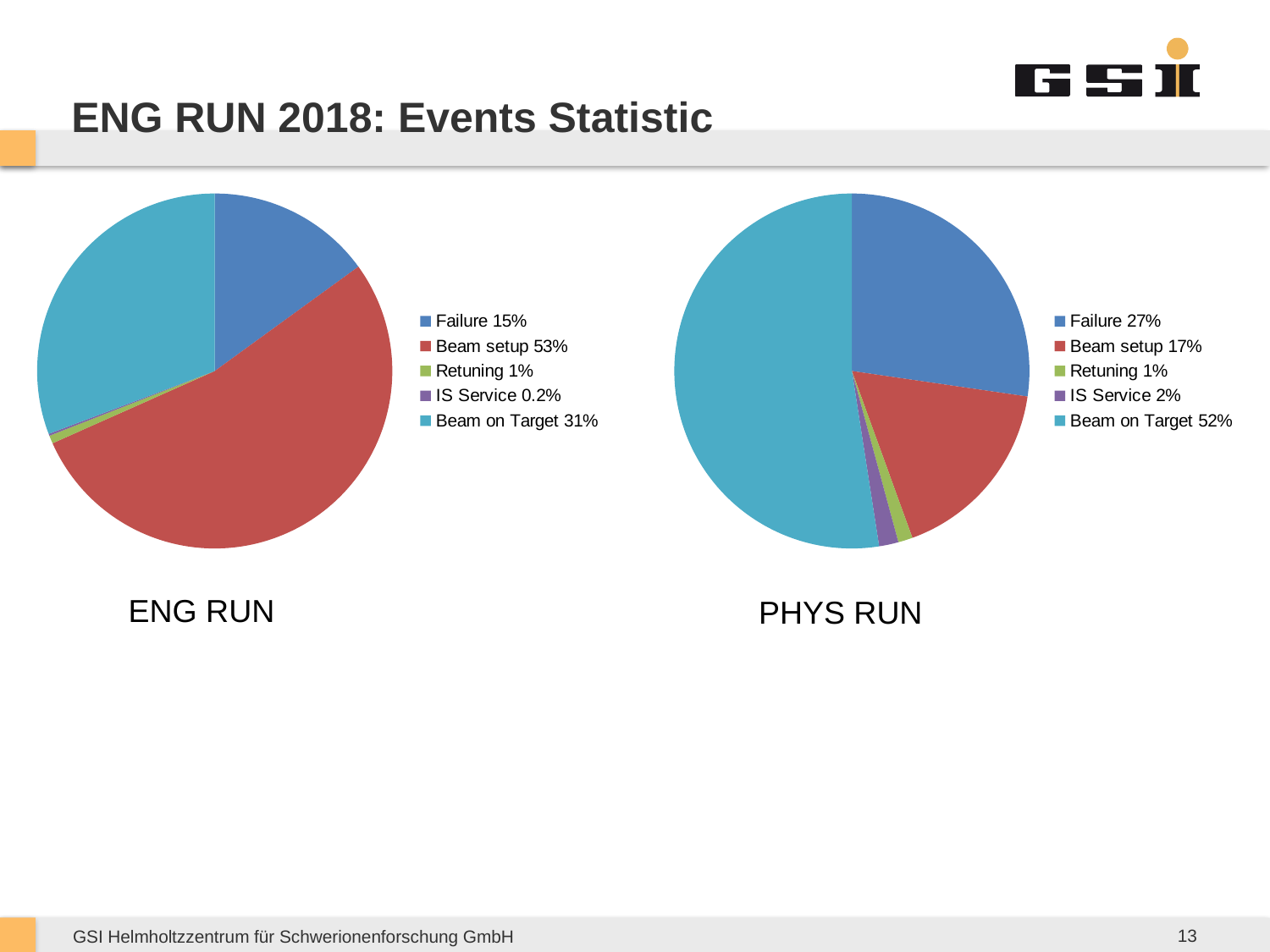
What type of chart is used for the ENG RUN data? Pie chart In the ENG RUN pie chart, which is larger: Beam setup or Beam on Target? Beam setup How many categories does the legend of the PHYS RUN pie chart list? 5 In the ENG RUN pie chart, which category has the smallest share? IS Service In the PHYS RUN pie chart, which category has the largest share? Beam on Target In the ENG RUN pie chart, which category has the largest share? Beam setup In the PHYS RUN pie chart, what share does Failure have? 27% In the ENG RUN pie chart, what share does IS Service have? 0.2% In the PHYS RUN pie chart, which category has the smallest share? Retuning What is the difference between the Failure share in the PHYS RUN chart and the Failure share in the ENG RUN chart? 12% In the PHYS RUN pie chart, what share does Beam on Target have? 52% In the ENG RUN pie chart, what share does Beam setup have? 53%